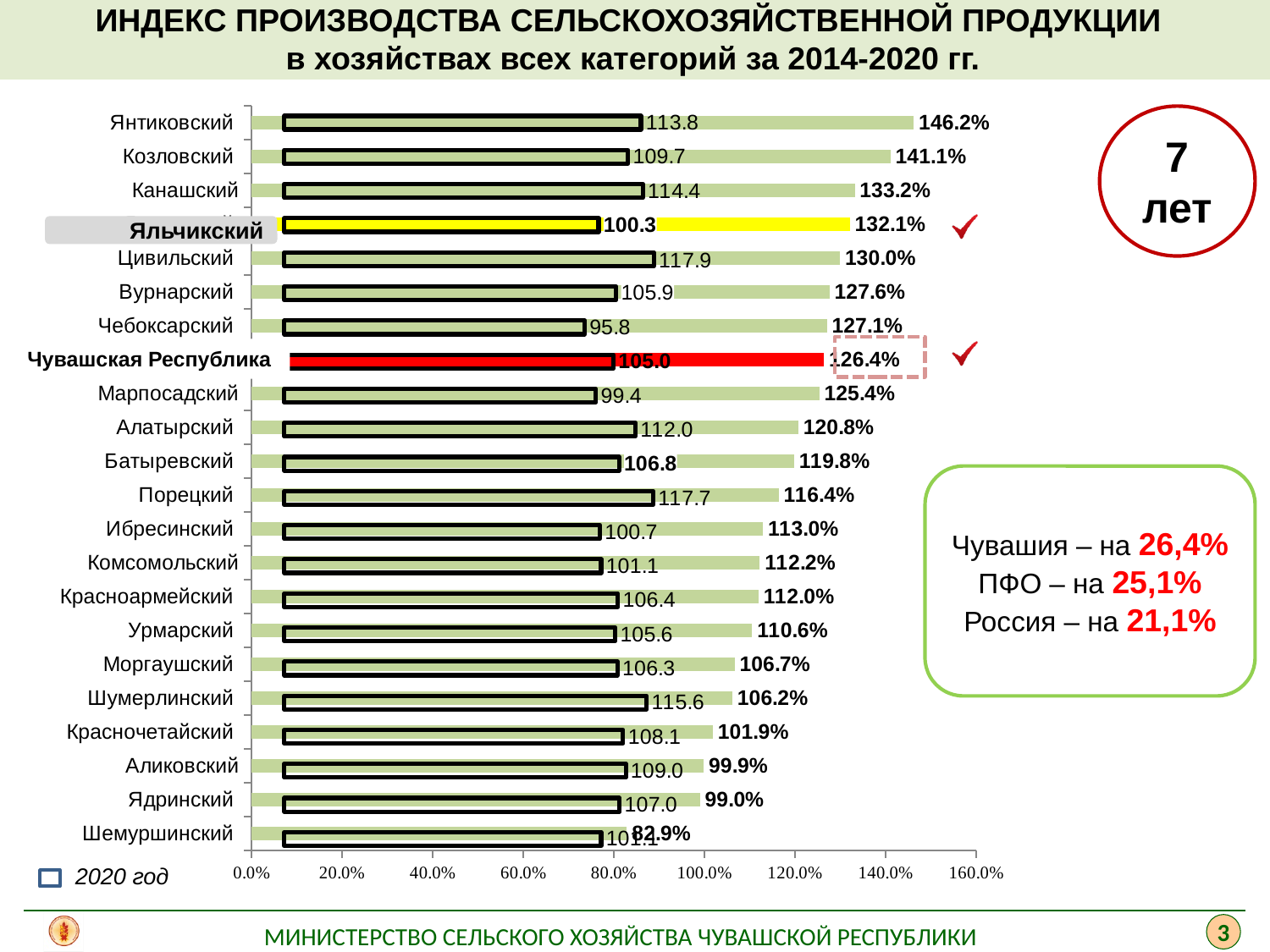
What type of chart is shown on the slide? bar chart What is the 7-year index value (percentage label) for Чувашская Республика? 126.4% Which category has the highest 7-year index value (percentage label)? Янтиковский What is the 2020 год value for Цивильский? 117.9 Which category has the lowest 7-year index value (percentage label)? Шемуршинский Which series is named in the chart legend? 2020 год What is the difference between the 7-year index values of Козловский (141.1%) and Канашский (133.2%)? 7.9% What is the 7-year index value (percentage label) for Янтиковский? 146.2% Which has a larger 2020 год value, Чебоксарский or Вурнарский? Вурнарский What is the 2020 год value for Яльчикский? 100.3 What is the 7-year index value (percentage label) for Ядринский? 99.0% How many categories are plotted on the chart? 22